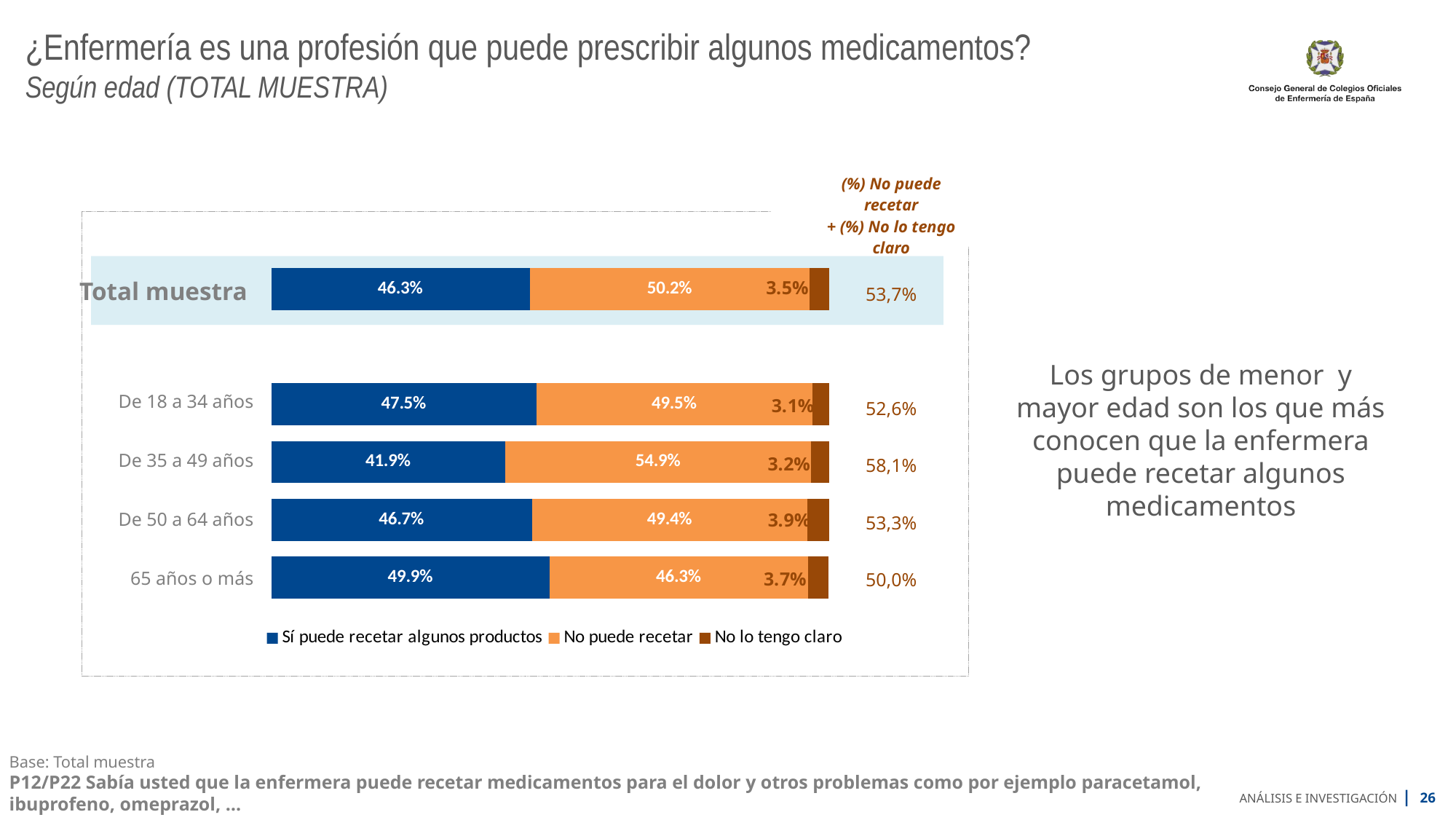
Which age group has the highest 'No puede recetar' value? De 35 a 49 años Which age group has the lowest 'Sí puede recetar algunos productos' value? De 35 a 49 años What is the 'No puede recetar' value for the 'Total muestra' bar? 50.2% What kind of chart is shown on the slide? Stacked bar chart How many series does the legend list? 3 What is the 'No lo tengo claro' value for the 'De 50 a 64 años' group? 3.9% Which age group has the highest 'Sí puede recetar algunos productos' value? 65 años o más How many bars (categories) are shown in the chart? 5 What percentage of the 'De 35 a 49 años' group answered 'Sí puede recetar algunos productos'? 41.9% What is the difference between the 'Sí puede recetar algunos productos' values for 'De 18 a 34 años' and 'De 35 a 49 años'? 5.6 percentage points Which is larger: the 'No puede recetar' value for 'De 18 a 34 años' or for '65 años o más'? De 18 a 34 años What combined '(%) No puede recetar + (%) No lo tengo claro' figure is shown for the 'De 35 a 49 años' group? 58,1%